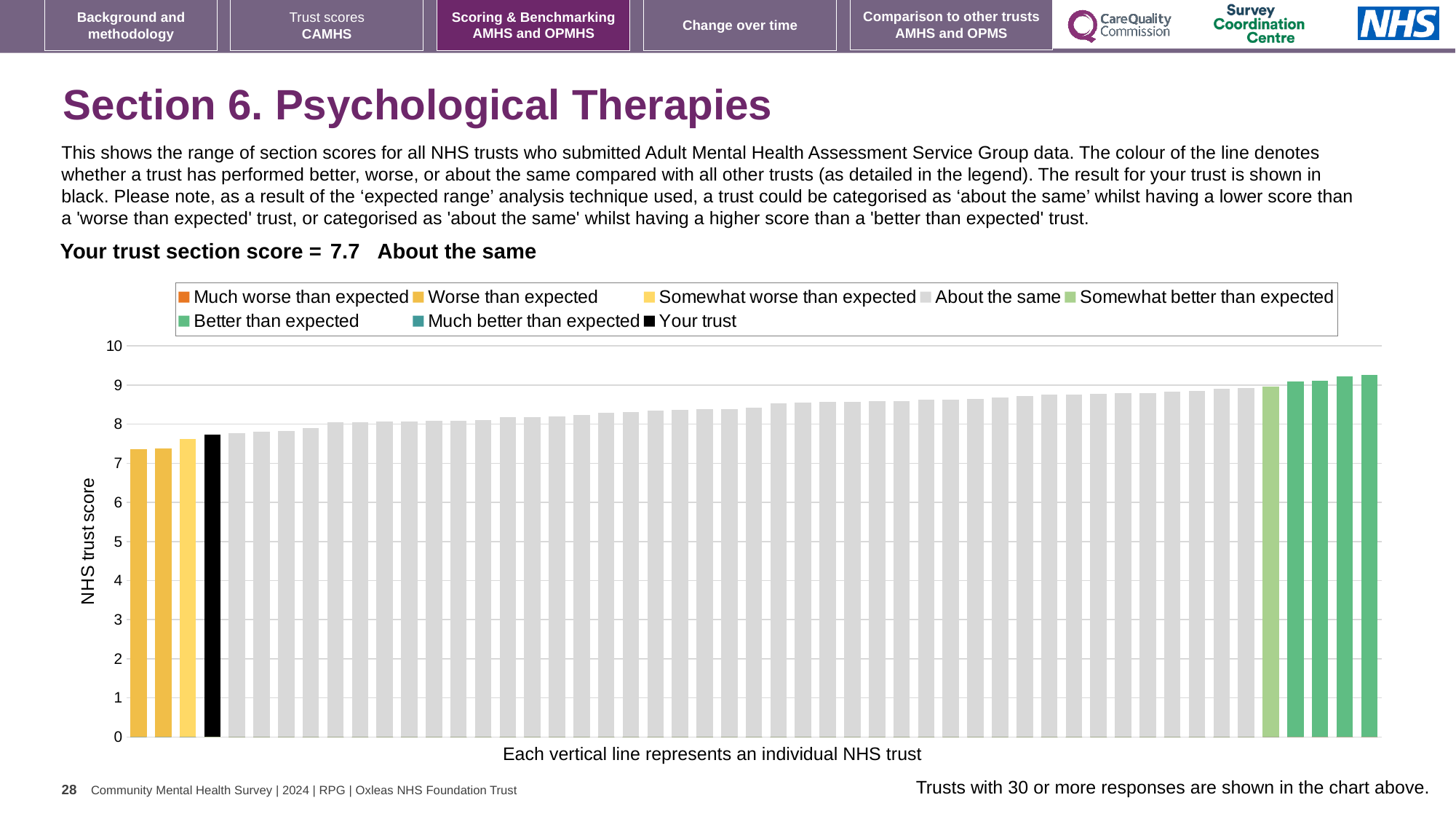
How many bars are coloured as 'Better than expected'? 4 What kind of chart is shown on the slide? bar chart How many entries does the chart legend list? 8 What is the label on the vertical axis of the chart? NHS trust score Do the bar values rise or fall from left to right across the chart? rise Is the value of the tallest bar in the chart greater or less than 9? greater Which legend category do the tallest bars in the chart belong to? Better than expected How many bars are coloured as 'Worse than expected'? 2 Is the value of the black 'Your trust' bar greater or less than 8? less What is the section score for your trust shown on the slide? 7.7 How many bars are coloured as 'Somewhat better than expected'? 1 Is the value of the shortest bar in the chart greater or less than 7? greater